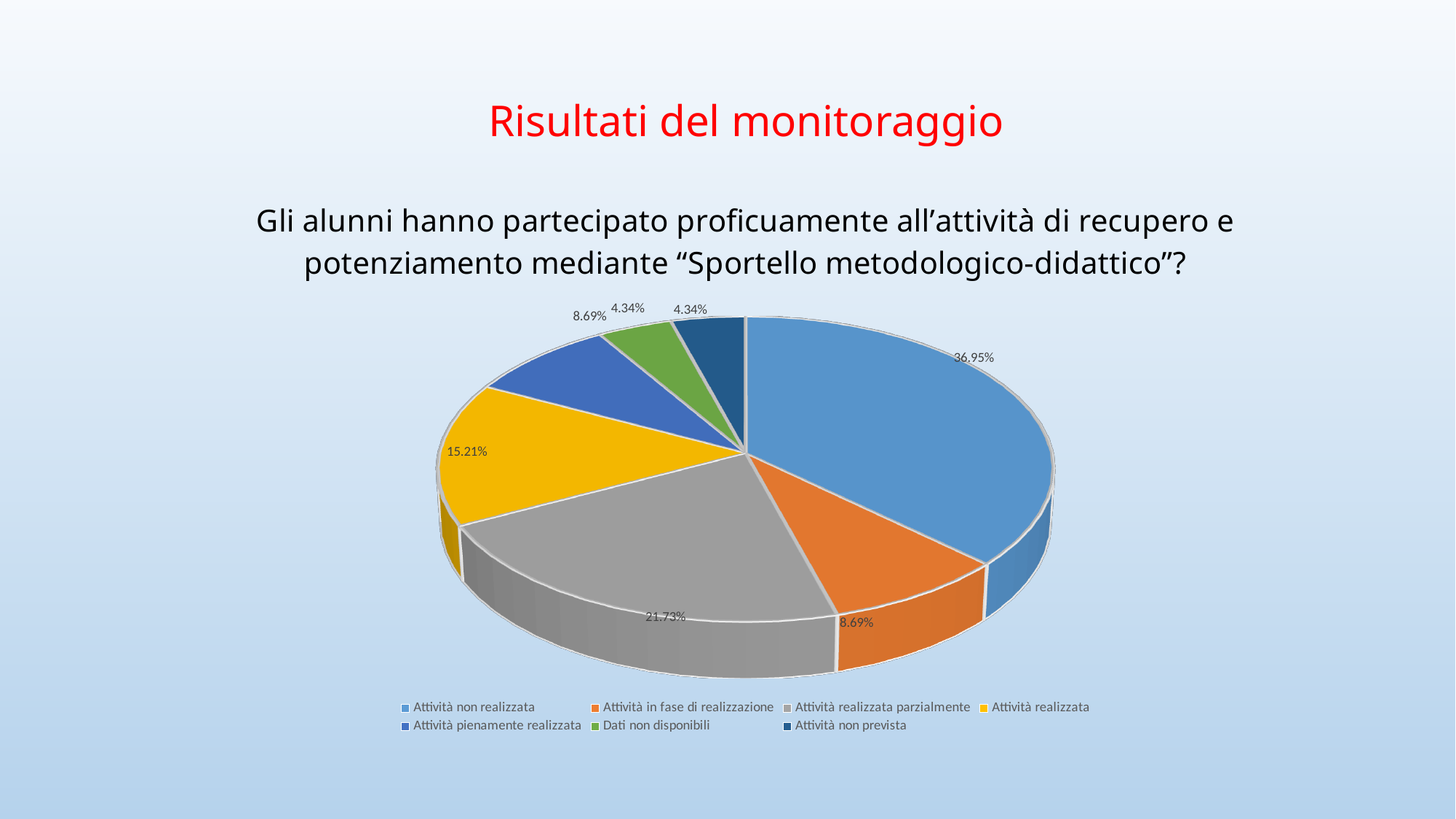
What is the value shown for "Attività realizzata parzialmente"? 21.73% What kind of chart is shown on the slide? pie chart What colour is the slice for "Attività realizzata"? yellow What is the value shown for "Dati non disponibili"? 4.34% How many categories does the legend of the pie chart list? 7 Which category has the largest slice of the pie? Attività non realizzata What is the combined share of "Dati non disponibili" and "Attività non prevista"? 8.68% What share of the pie does "Attività non realizzata" represent? 36.95% Which is larger, the slice for "Attività realizzata" or the slice for "Attività in fase di realizzazione"? Attività realizzata What is the value shown for "Attività pienamente realizzata"? 8.69% What is the difference between the values for "Attività non realizzata" and "Attività realizzata parzialmente"? 15.22% What is the value shown for "Attività realizzata"? 15.21%